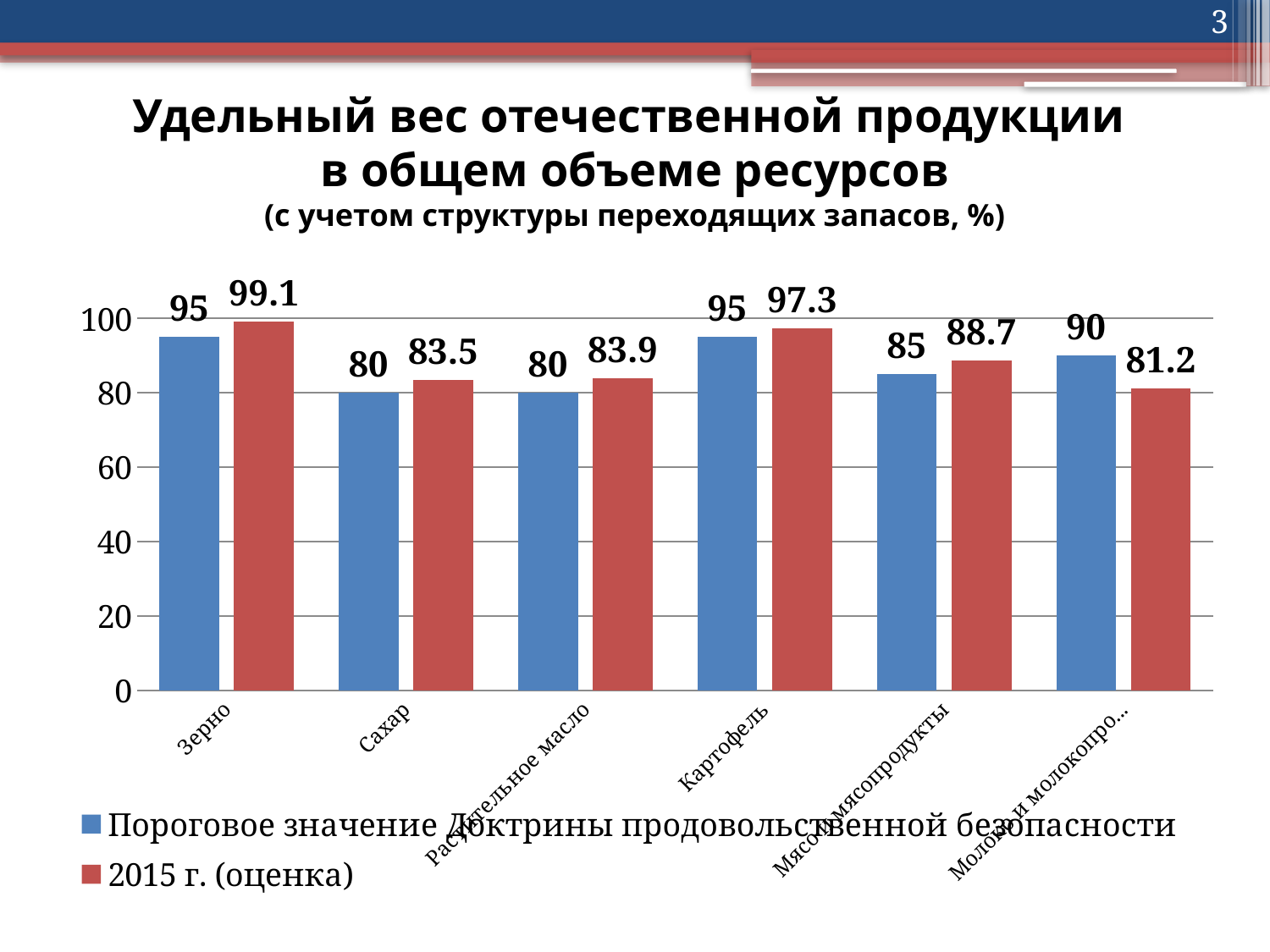
What is the difference between the 2015 г. (оценка) value and the Пороговое значение for Картофель? 2.3 What is the 2015 г. (оценка) value for Растительное масло? 83.9 What kind of chart is shown on the slide? Bar chart What is the 2015 г. (оценка) value for Мясо и мясопродукты? 88.7 Which category has the highest 2015 г. (оценка) value? Зерно Which category has the lowest 2015 г. (оценка) value? The last category (Молоко и молокопро...) How many categories are shown on the x axis? 6 What is the 2015 г. (оценка) value for Зерно? 99.1 For the last category (Молоко и молокопро...), which is larger: the Пороговое значение or the 2015 г. (оценка) value? Пороговое значение What is the Пороговое значение Доктрины продовольственной безопасности value for Сахар? 80 Which colour represents the 2015 г. (оценка) series? Red How many series does the legend list? 2